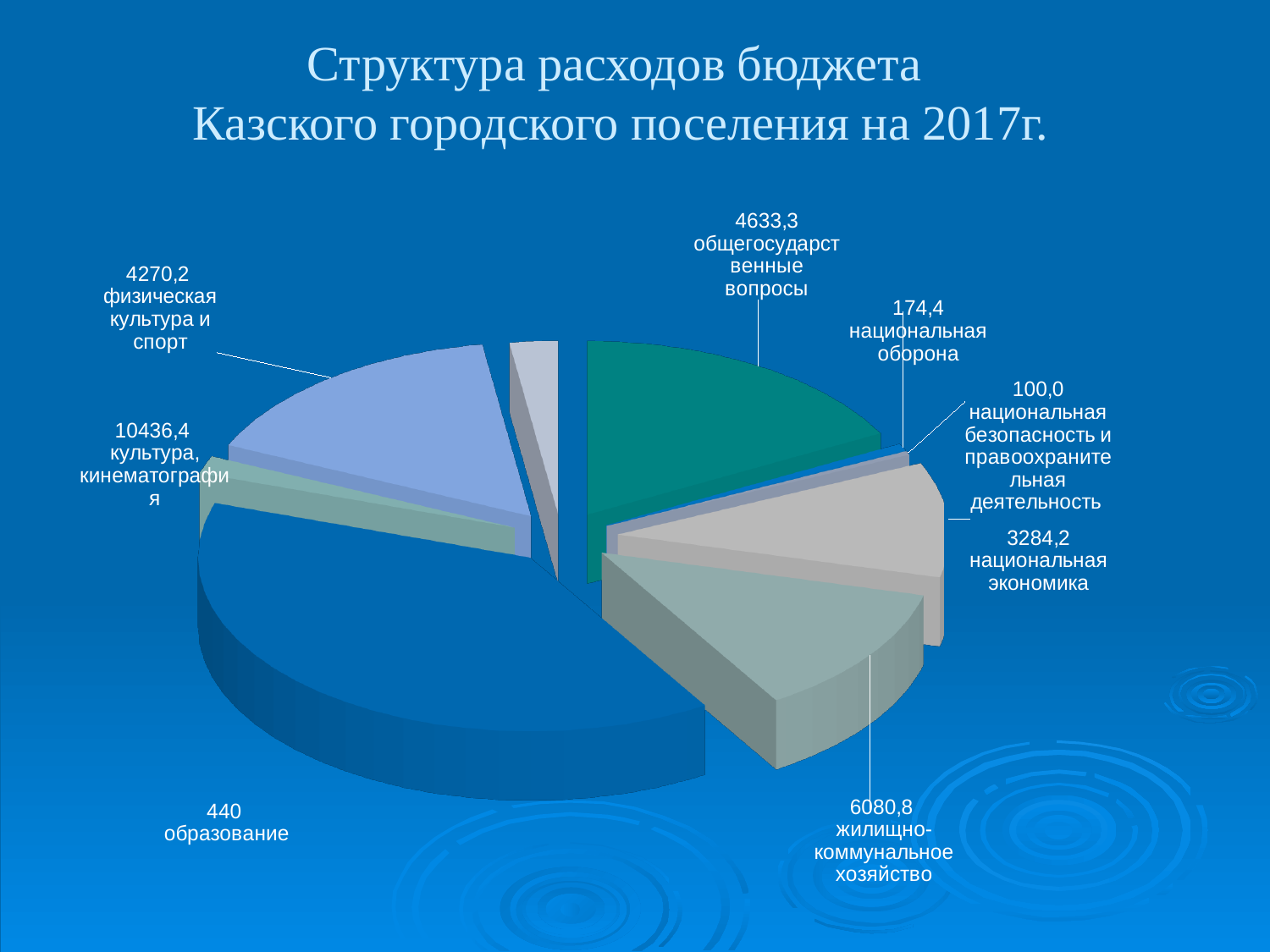
What is the value for жилищно-коммунальное хозяйство? 6080,8 What is the difference between национальная экономика and образование? 2844,2 What is the value for национальная оборона? 174,4 How many categories are shown in the pie chart? 9 What is the difference between жилищно-коммунальное хозяйство and общегосударственные вопросы? 1447,5 What kind of chart is shown on the slide? pie chart What is the title of the slide? Структура расходов бюджета Казского городского поселения на 2017г. Which category has the highest value? культура, кинематография Which is larger: национальная экономика or жилищно-коммунальное хозяйство? жилищно-коммунальное хозяйство What is the value for физическая культура и спорт? 4270,2 What is the value for общегосударственные вопросы? 4633,3 Which category has the lowest value? национальная безопасность и правоохранительная деятельность